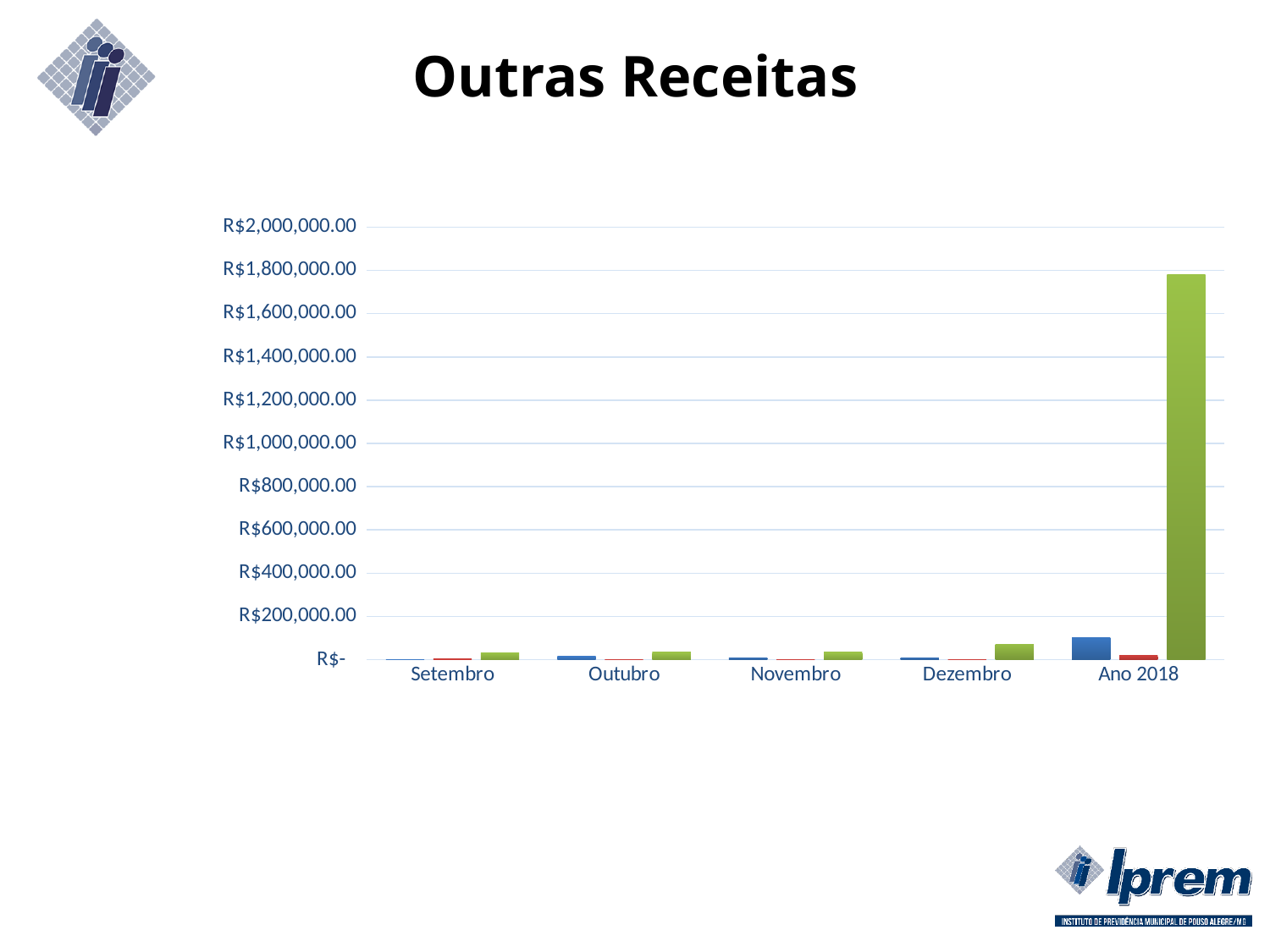
Which category has the tallest bar in the chart? Ano 2018 Is the value of the blue bar for Ano 2018 greater or less than R$200,000.00? less Which is larger, the green bar for Dezembro or the blue bar for Dezembro? the green bar Is the value of the green bar for Ano 2018 greater or less than R$1,800,000.00? less What is the highest value shown on the chart's vertical axis? R$2,000,000.00 How many bars are plotted for each category in the chart? 3 Which is larger, the green bar for Ano 2018 or the green bar for Setembro? Ano 2018 Is the value of the green bar for Ano 2018 greater or less than R$1,600,000.00? greater How many categories are shown on the x axis of the chart? 5 Which category is the last one on the x axis of the chart? Ano 2018 What kind of chart is shown on the slide? bar chart What is the title of the slide's chart? Outras Receitas